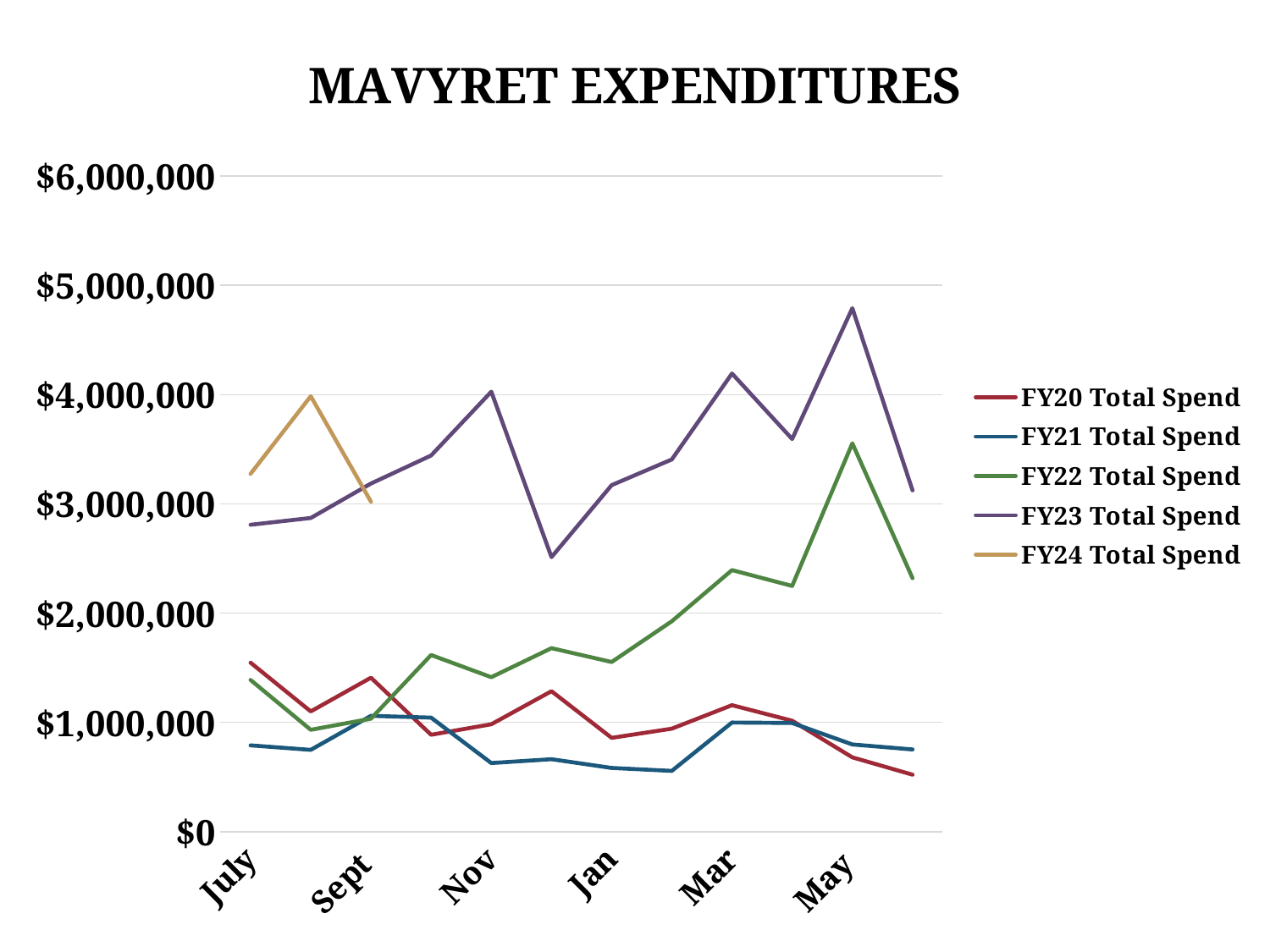
Which series reaches the highest value on the chart? FY23 Total Spend At Mar, which is larger: FY23 Total Spend or FY22 Total Spend? FY23 Total Spend Is the value for FY23 Total Spend at July greater or less than $3,000,000? less Is the value for FY23 Total Spend at Mar greater or less than $4,000,000? greater What is the title of the chart? MAVYRET EXPENDITURES Does FY22 Total Spend rise or fall from Jan to Mar? rise What kind of chart is shown on the slide? line chart Is the value for FY24 Total Spend at July greater or less than $3,000,000? greater How many month labels are shown on the x axis? 6 How many series does the legend list? 5 Which series has the lowest value at July? FY21 Total Spend